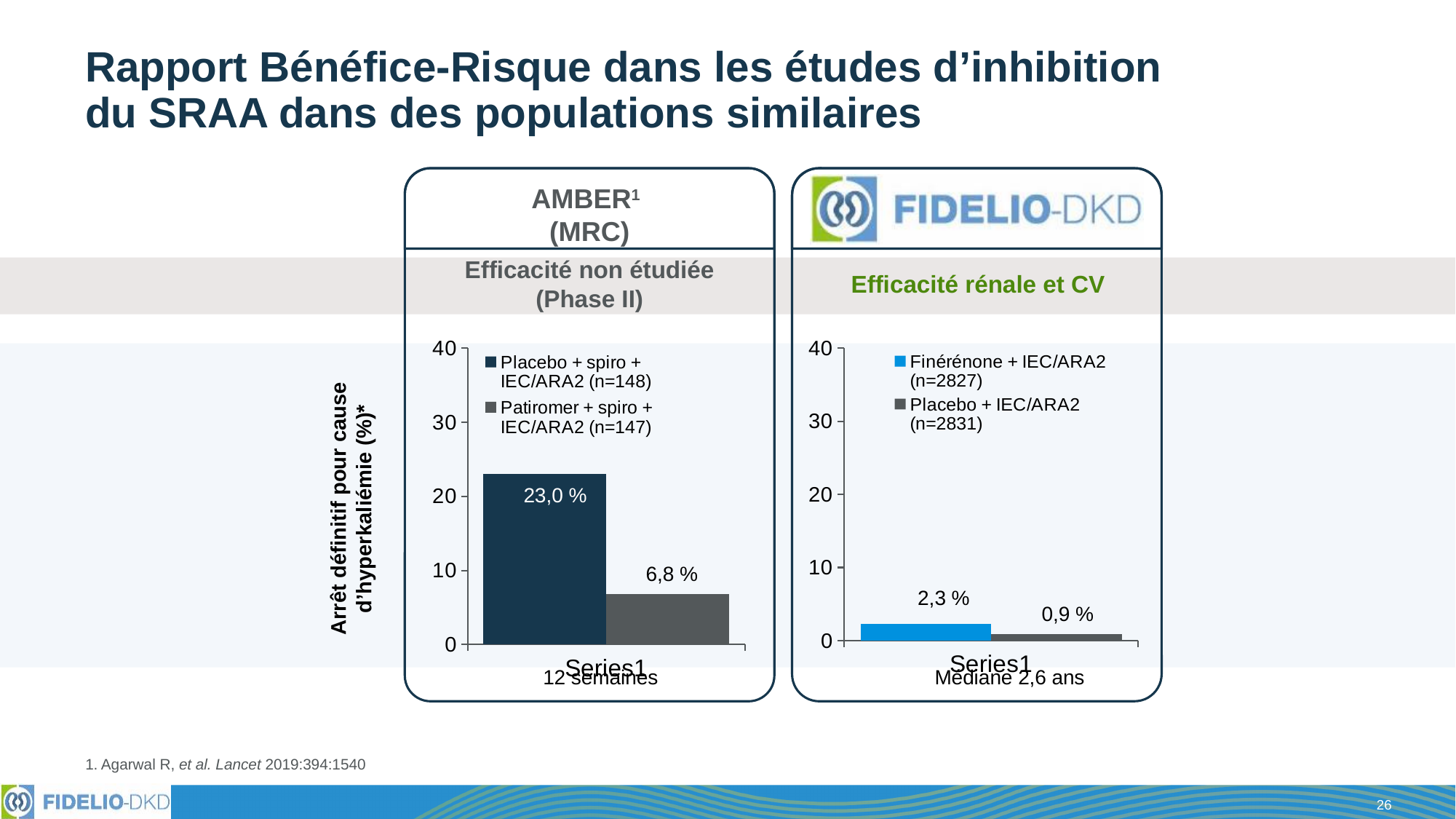
Is the Placebo + spiro + IEC/ARA2 value in the AMBER chart on the left greater or less than 20? greater In the AMBER chart on the left, what is the difference between the Placebo + spiro + IEC/ARA2 value and the Patiromer + spiro + IEC/ARA2 value? 16,2 % In the FIDELIO-DKD chart on the right, which series has the lower value? Placebo + IEC/ARA2 (n=2831) What is the y-axis label shared by the two charts? Arrêt définitif pour cause d'hyperkaliémie (%)* In the AMBER chart on the left, what is the value for Patiromer + spiro + IEC/ARA2 (n=147)? 6,8 % In the FIDELIO-DKD chart on the right, what is the value for Finérénone + IEC/ARA2 (n=2827)? 2,3 % In the FIDELIO-DKD chart on the right, what is the value for Placebo + IEC/ARA2 (n=2831)? 0,9 % What kind of chart is the AMBER chart on the left? bar chart In the AMBER chart on the left, what is the value for Placebo + spiro + IEC/ARA2 (n=148)? 23,0 % In the AMBER chart on the left, which series has the higher value? Placebo + spiro + IEC/ARA2 (n=148) How many series does the legend of the FIDELIO-DKD chart on the right list? 2 In the FIDELIO-DKD chart on the right, what is the difference between the Finérénone + IEC/ARA2 value and the Placebo + IEC/ARA2 value? 1,4 %